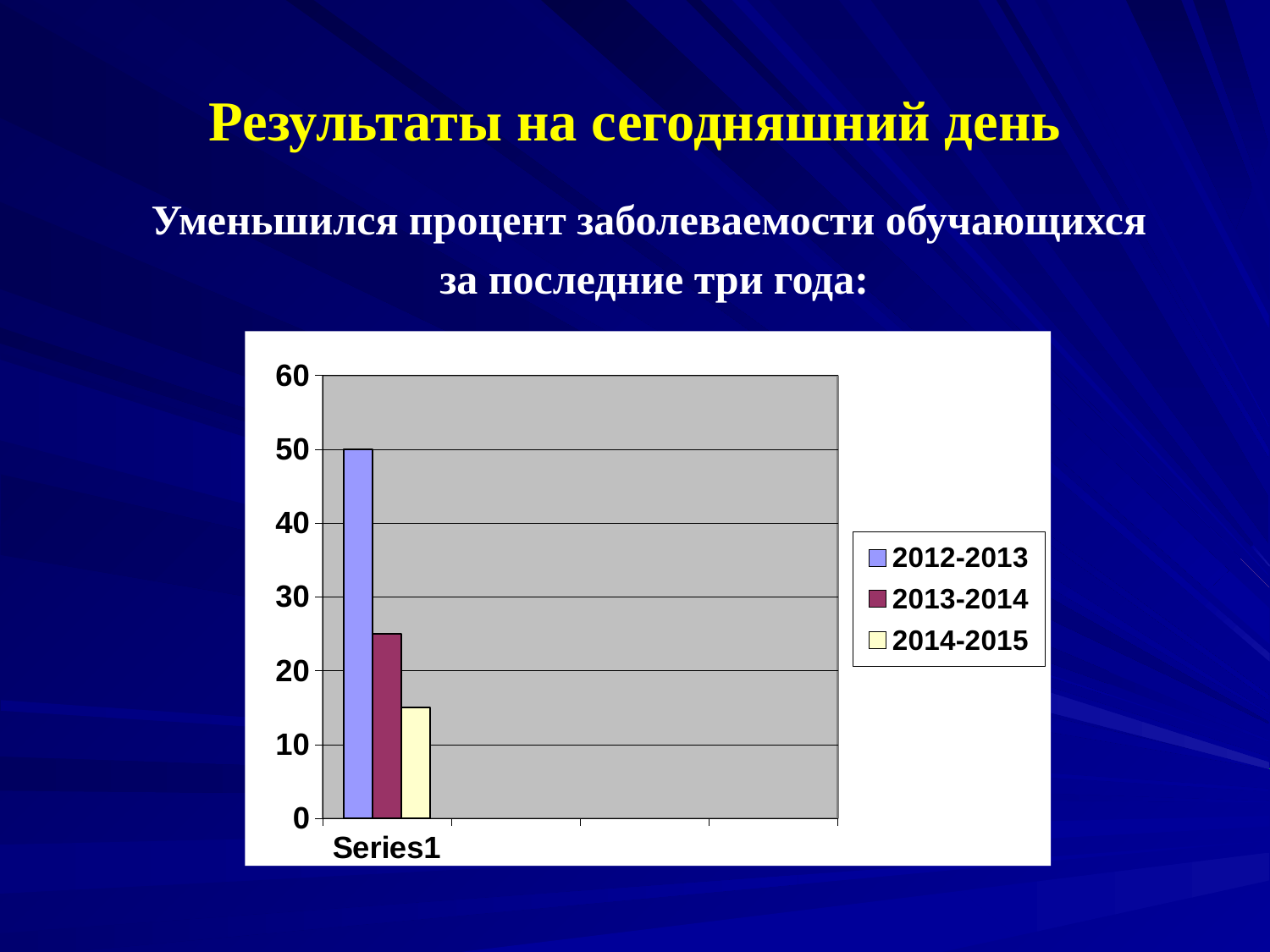
Which series has the lowest bar? 2014-2015 What is the label of the category on the x axis? Series1 Is the value for 2013-2014 greater or less than 30? less What is the value of the 2012-2013 bar? 50 What kind of chart is shown on the slide? bar chart Do the bar values rise or fall from 2012-2013 to 2014-2015? fall Which is larger, the bar for 2013-2014 or the bar for 2014-2015? 2013-2014 Which series has the highest bar? 2012-2013 How many series does the chart legend list? 3 How many categories are shown on the x axis? 1 Is the value for 2014-2015 greater or less than 20? less Is the value for 2013-2014 greater or less than 20? greater